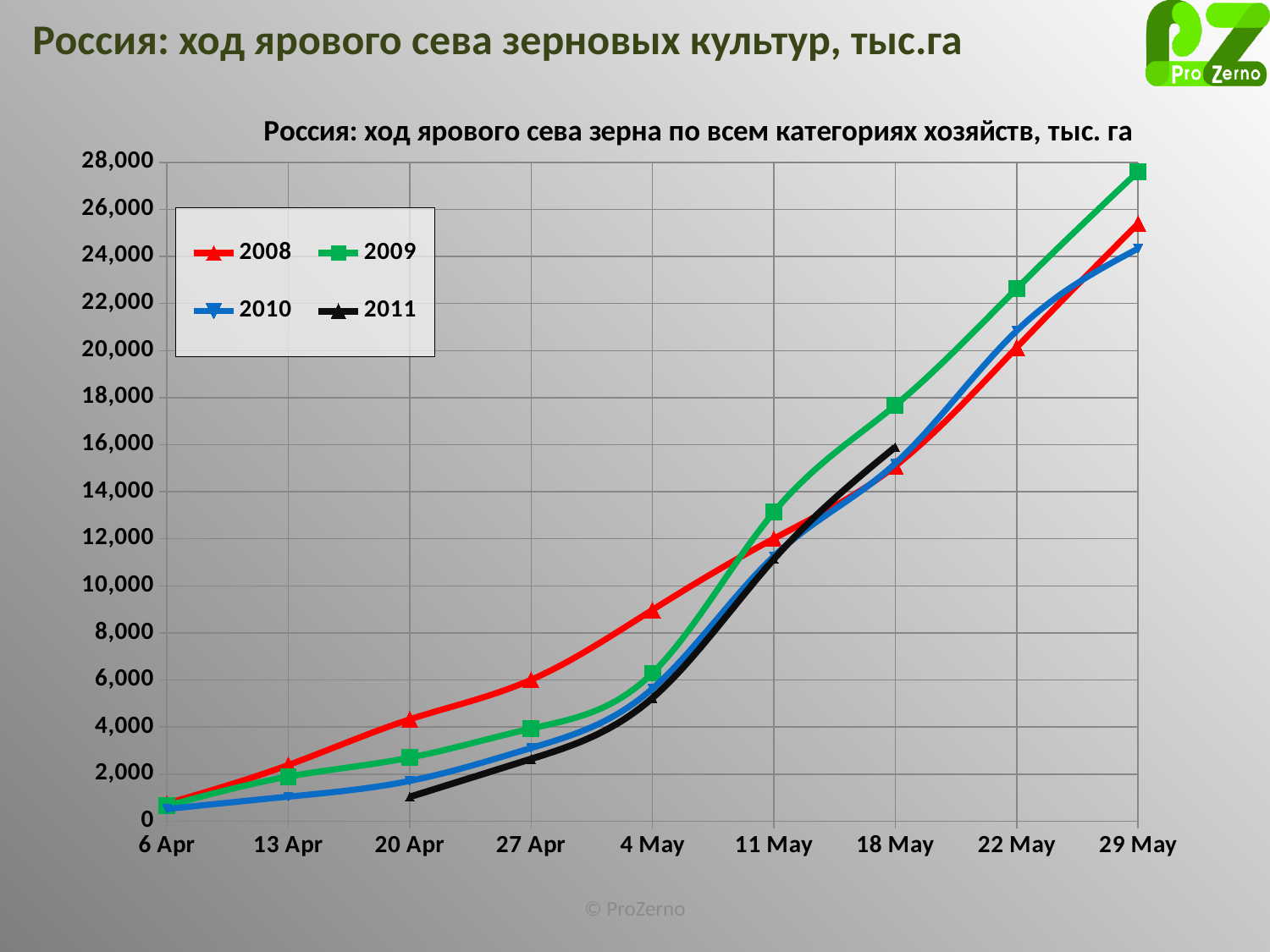
Is the value for 2009 on 29 May greater or less than 26,000? greater Do the values for the 2010 series rise or fall from 6 Apr to 29 May? rise How many series does the legend list? 4 Is the value for 2011 on 20 Apr greater or less than 2,000? less Which series has the lowest value on 20 Apr? 2011 How many dates are shown along the x axis? 9 Which colour is used for the 2011 series? black Is the value for 2009 on 11 May greater or less than 12,000? greater Which series has the highest value on 29 May? 2009 On 4 May, which series has the larger value, 2008 or 2009? 2008 What kind of chart is shown on the slide? line chart What is the title of the chart? Россия: ход ярового сева зерна по всем категориях хозяйств, тыс. га